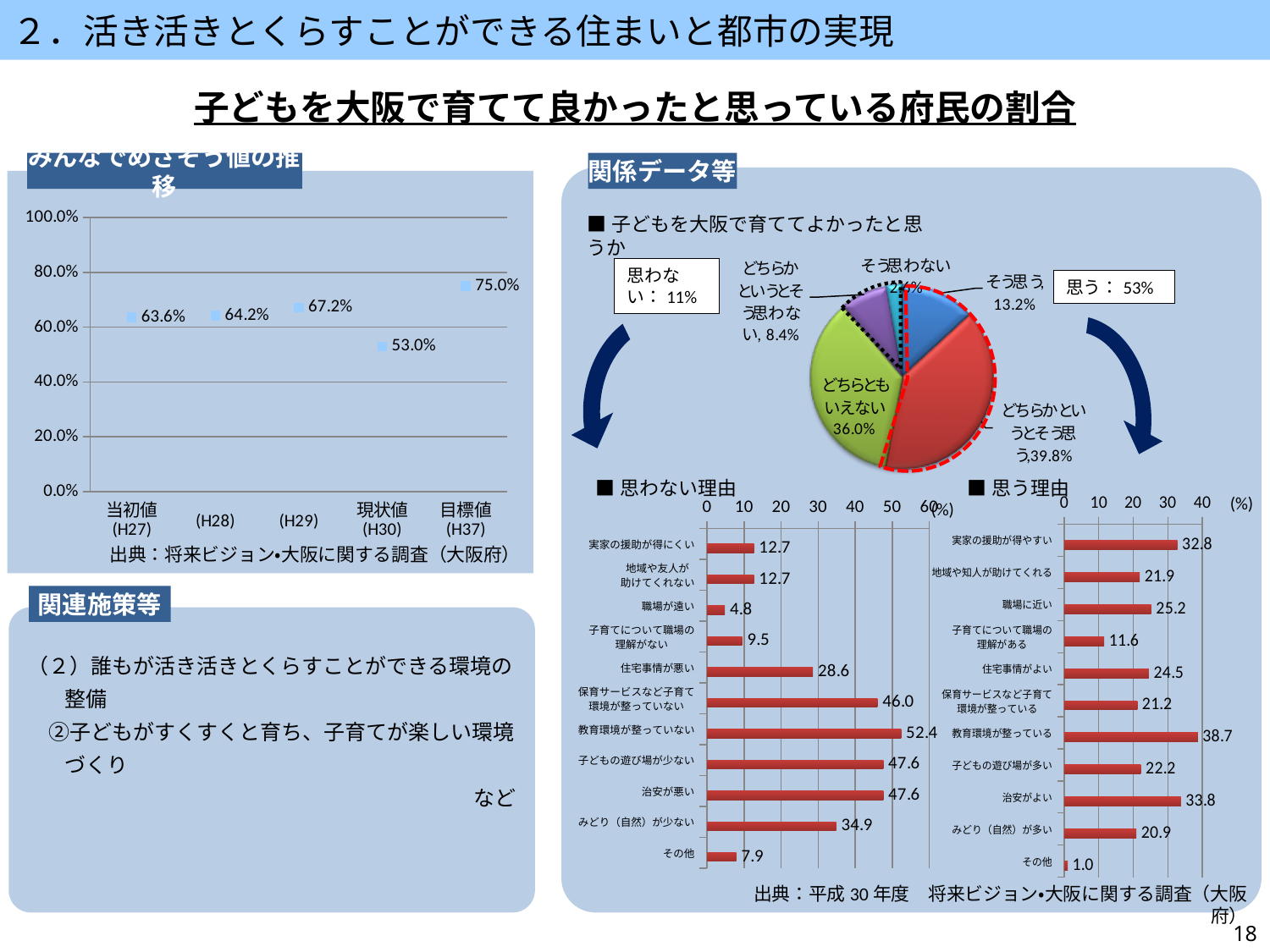
In the 「みんなでめざそう値の推移」 chart, what is the difference between the H29 value and the 現状値 (H30) value? 14.2% In the 「みんなでめざそう値の推移」 chart, what is the value for 当初値 (H27)? 63.6% In the pie chart 「子どもを大阪で育ててよかったと思うか」, which is larger: そう思う or どちらかというとそう思う? どちらかというとそう思う In the 「思わない理由」 bar chart, what is the value for 教育環境が整っていない? 52.4 In the 「みんなでめざそう値の推移」 chart, what is the value for 目標値 (H37)? 75.0% In the 「みんなでめざそう値の推移」 chart, which point has the lowest value? 現状値 (H30) In the 「思う理由」 bar chart, which category has the highest value? 教育環境が整っている In the 「思わない理由」 bar chart, how many categories are shown? 11 In the 「思う理由」 bar chart, what is the difference between 実家の援助が得やすい and 治安がよい? 1.0 What kind of chart is the 「思う理由」 chart? Bar chart In the 「思わない理由」 bar chart, which category has the lowest value? 職場が遠い In the pie chart 「子どもを大阪で育ててよかったと思うか」, what share is どちらともいえない? 36.0%